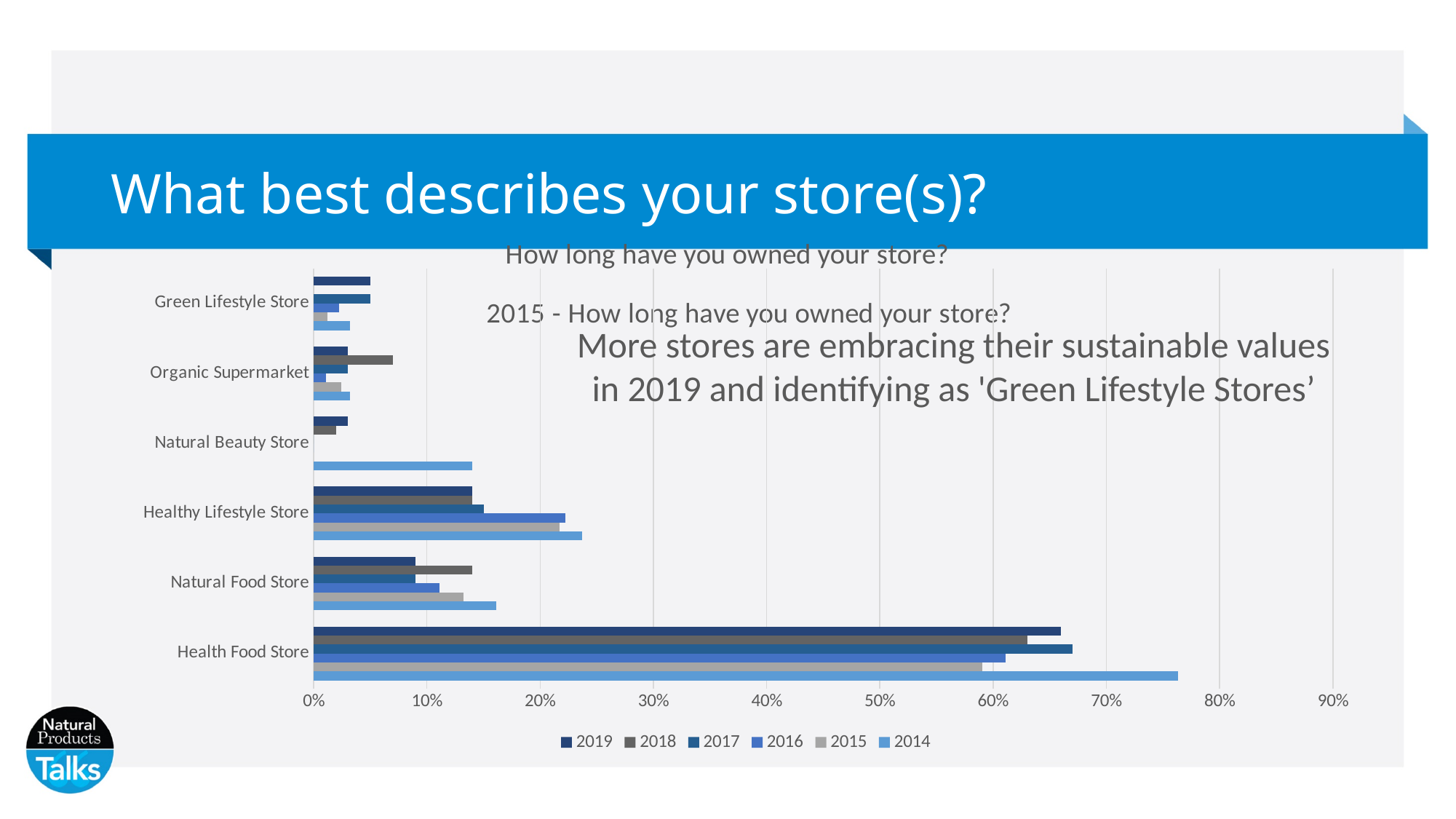
Which store category has the longest bars on the chart? Health Food Store For Healthy Lifestyle Store, which is larger: the 2016 value or the 2019 value? 2016 Is the 2014 value for Health Food Store greater or less than 70%? greater How many store categories are listed on the chart's vertical axis? 6 Is the 2019 value for Natural Food Store greater or less than 10%? less Is the 2019 value for Health Food Store greater or less than 60%? greater For Health Food Store, which is larger: the 2014 value or the 2019 value? 2014 Which year is listed first in the chart legend? 2019 What is the highest percentage tick shown on the horizontal axis? 90% What kind of chart is shown on the slide? bar chart How many series does the chart legend list? 6